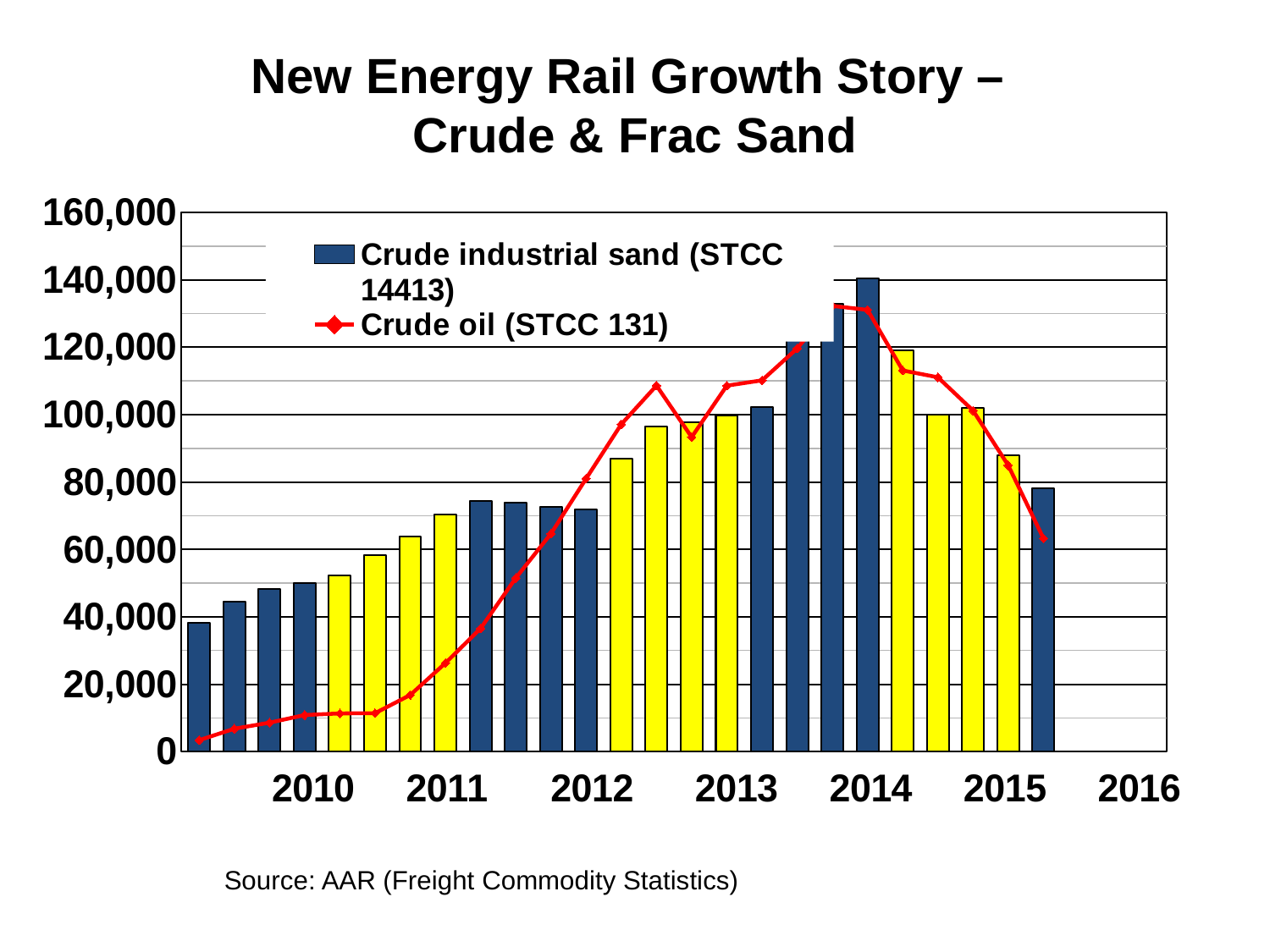
Does the Crude oil (STCC 131) line rise or fall from 2010 to 2014? rise Is the first Crude industrial sand bar greater or less than 60,000? less How many series does the legend list? 2 Is the highest point of the Crude oil (STCC 131) line greater or less than 120,000? greater What is the title of the chart on the slide? New Energy Rail Growth Story – Crude & Frac Sand Which series is drawn as a red line with diamond markers? Crude oil (STCC 131) In which year does the tallest Crude industrial sand bar occur? 2014 In which year does the shortest Crude industrial sand bar occur? 2010 What are the two series named in the legend? Crude industrial sand (STCC 14413) and Crude oil (STCC 131) Is the last point of the Crude oil (STCC 131) line greater or less than 80,000? less What kind of chart is shown on the slide? A bar chart combined with a line chart